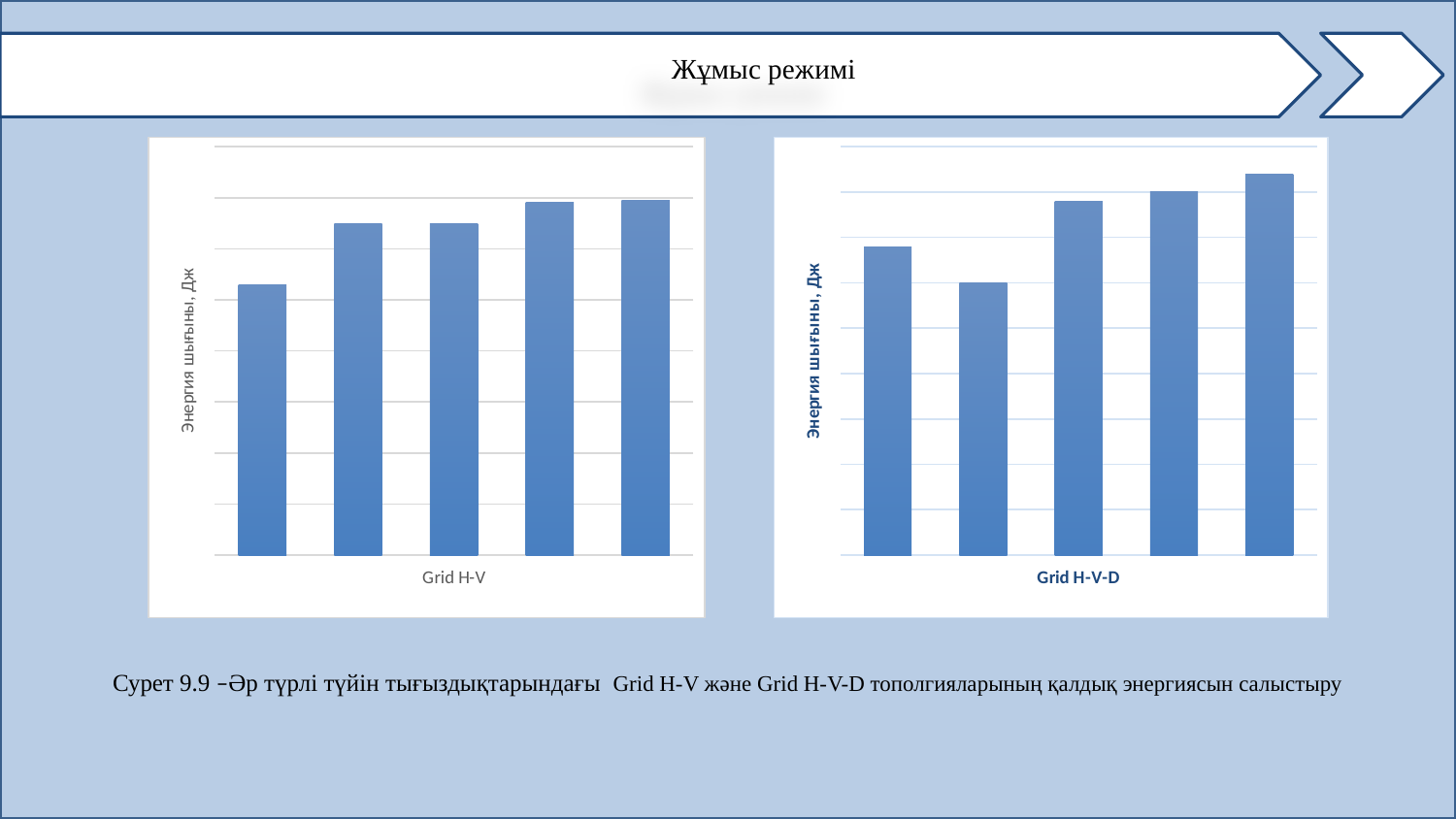
In the right chart labelled Grid H-V-D, which bar is the highest? the fifth bar from the left In the right chart labelled Grid H-V-D, which bar is the lowest? the second bar from the left What is the x-axis label shown under the right chart? Grid H-V-D In the left chart labelled Grid H-V, do the bar values generally rise or fall from left to right? rise What is the y-axis title of the left chart labelled Grid H-V? Энергия шығыны, Дж How many bars are plotted in the left chart labelled Grid H-V? 5 In the left chart labelled Grid H-V, which is larger: the first bar or the second bar? the second bar What kind of chart is the left chart labelled Grid H-V? bar chart How many bars are plotted in the right chart labelled Grid H-V-D? 5 What kind of chart is the right chart labelled Grid H-V-D? bar chart In the right chart labelled Grid H-V-D, which is larger: the first bar or the second bar? the first bar In the left chart labelled Grid H-V, which bar is the lowest? the first bar from the left